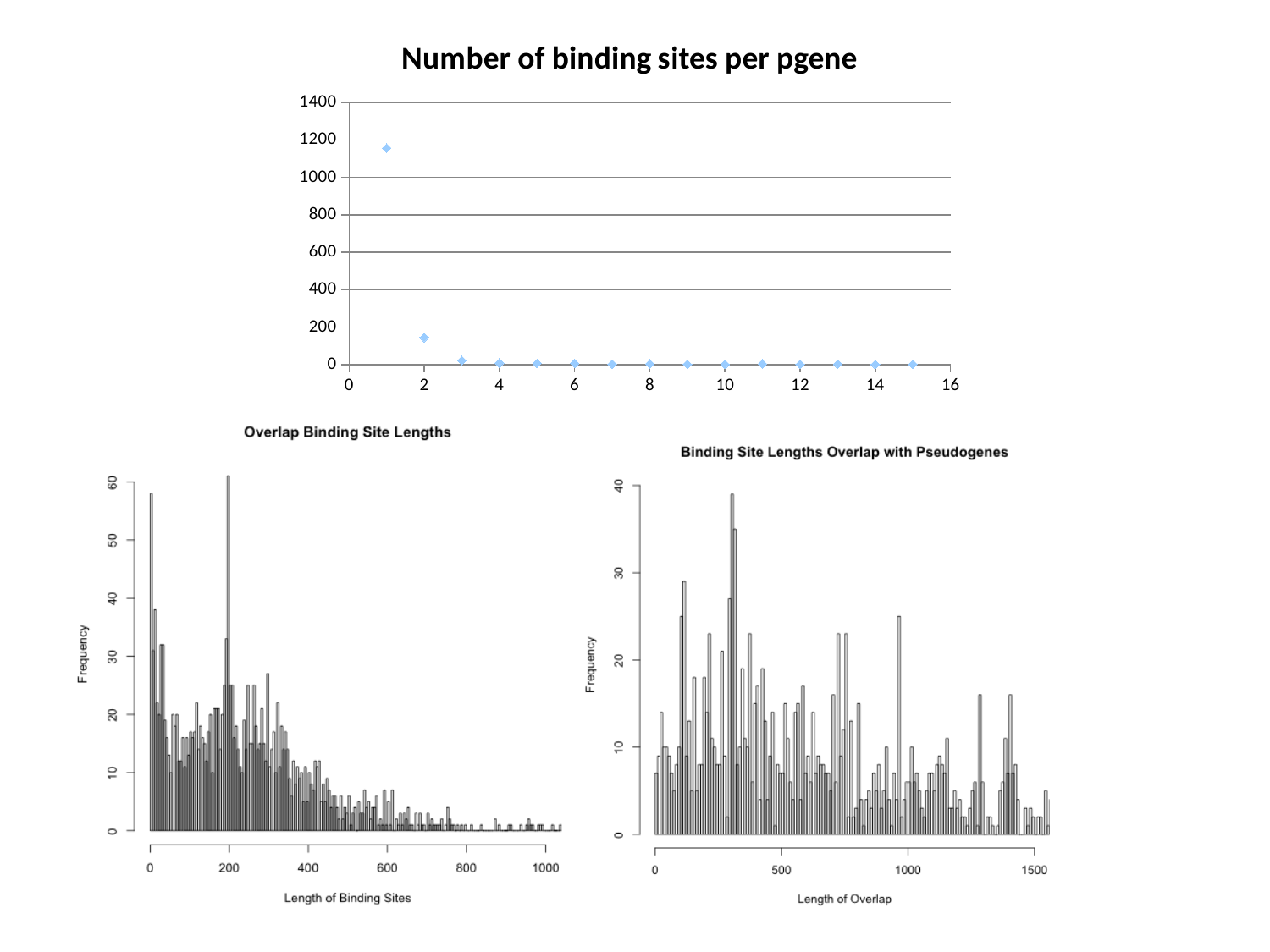
In the top chart 'Number of binding sites per pgene', how many data points are plotted? 15 In the bottom-left chart 'Overlap Binding Site Lengths', is the tallest bar's frequency greater or less than 50? greater In the top chart 'Number of binding sites per pgene', at which x value is the plotted value highest? 1 In the bottom-right chart 'Binding Site Lengths Overlap with Pseudogenes', is the tallest bar's frequency greater or less than 30? greater What is the x-axis label of the bottom-left chart 'Overlap Binding Site Lengths'? Length of Binding Sites In the top chart 'Number of binding sites per pgene', is the value at x = 2 greater or less than 200? less In the top chart 'Number of binding sites per pgene', do the values rise or fall as x increases? fall What is the title of the chart at the top of the slide? Number of binding sites per pgene What kind of chart is the top chart, 'Number of binding sites per pgene'? scatter plot What kind of chart is the bottom-right chart 'Binding Site Lengths Overlap with Pseudogenes'? bar chart (histogram) In the top chart 'Number of binding sites per pgene', which has the larger value, x = 1 or x = 2? x = 1